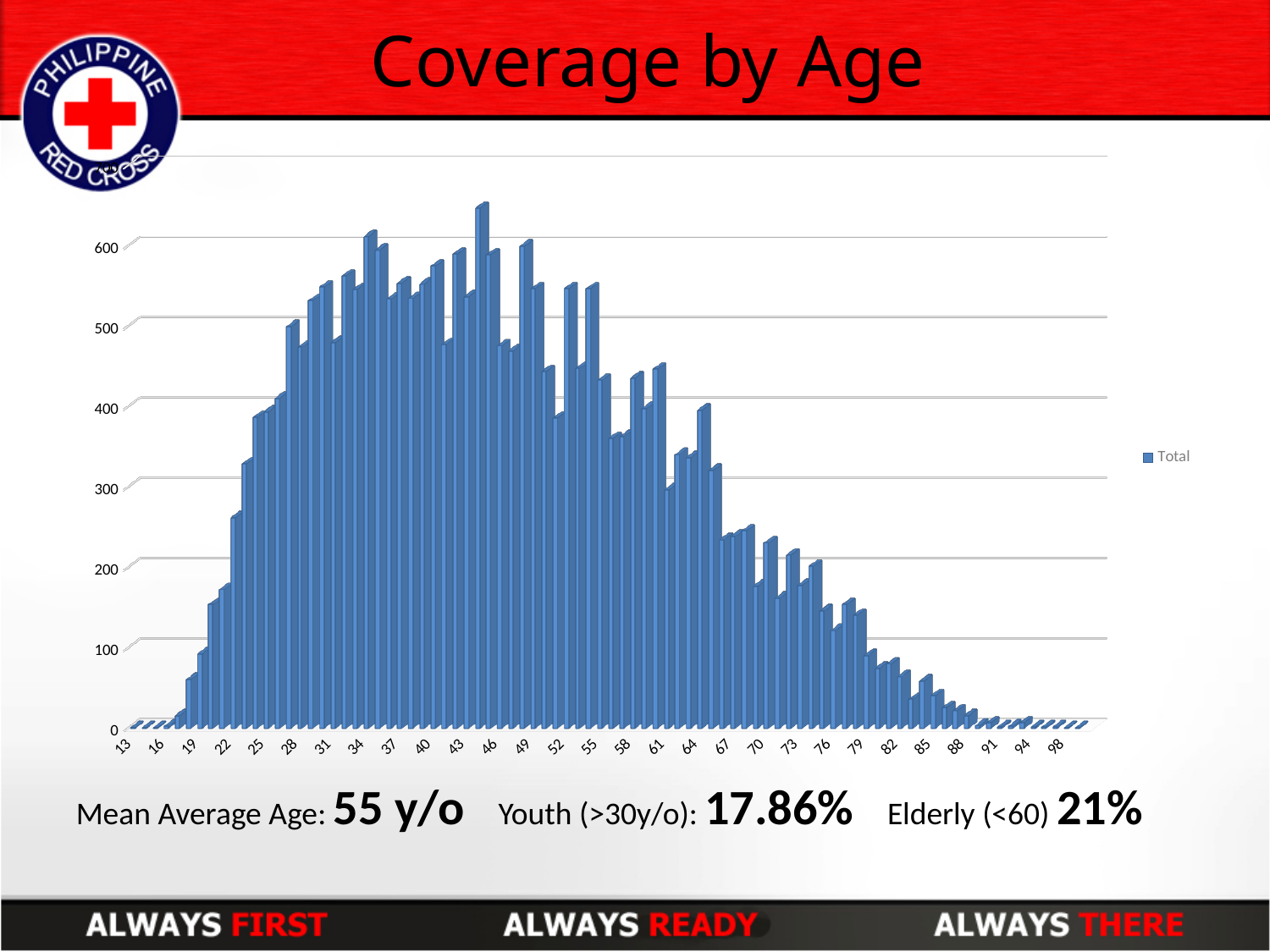
Is the value for age 88 greater or less than 100? less Is the value for age 22 greater or less than 100? greater What is the name of the series shown in the legend? Total What is the title of the chart? Coverage by Age What kind of chart is shown on the slide? bar chart Do the values rise or fall along the x axis from age 64 to age 98? fall Do the values rise or fall along the x axis from age 13 to age 25? rise Is the value for age 25 greater or less than 300? greater How many series does the legend list? 1